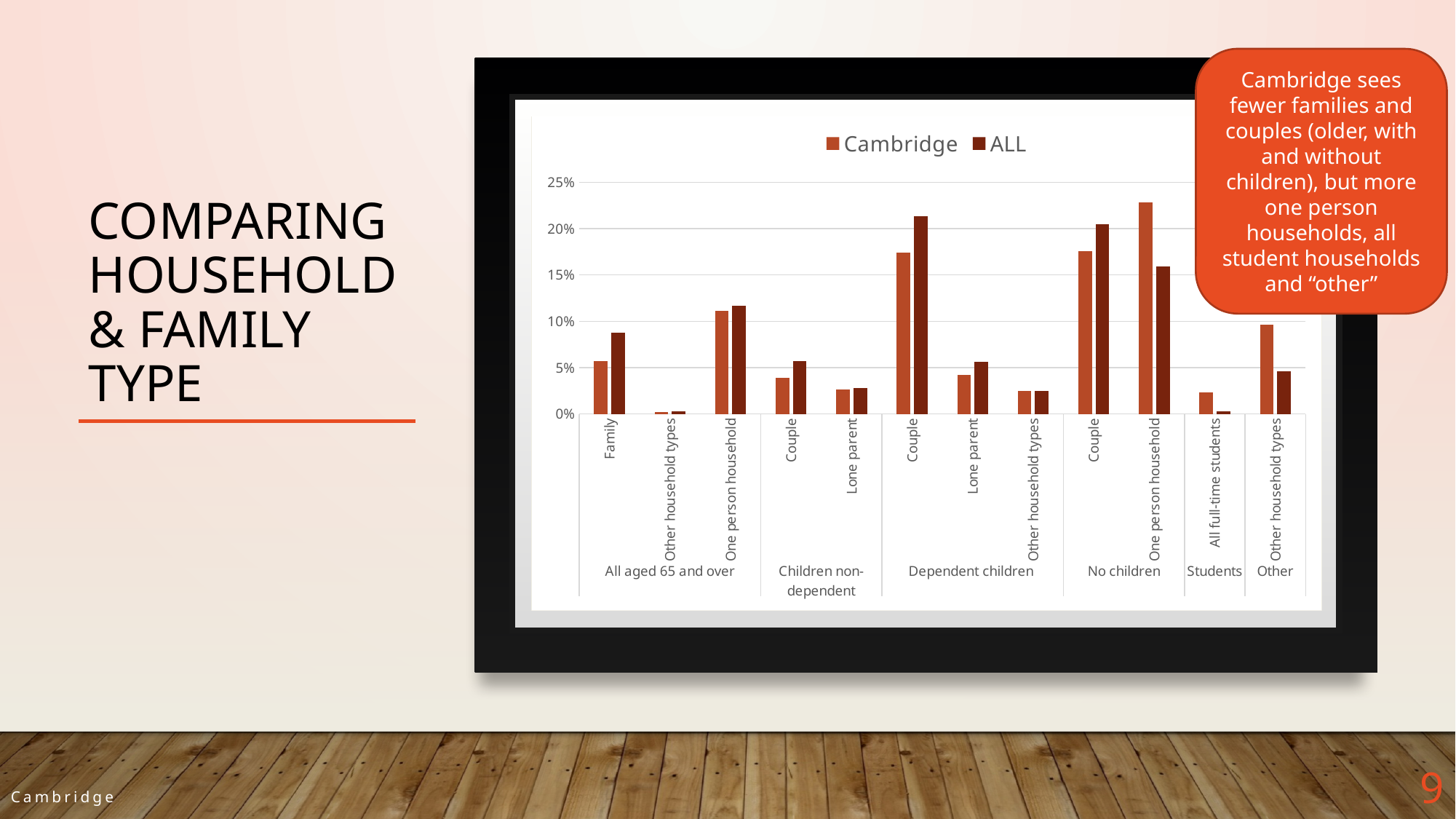
Which category has the lowest Cambridge value in the chart? Other household types (All aged 65 and over) Which category has the highest ALL value in the chart? Couple (Dependent children) Is the ALL value for Family (All aged 65 and over) greater or less than 10%? less What are the two series named in the chart legend? Cambridge and ALL How many household-type categories are plotted along the x axis of the chart? 12 Is the Cambridge value for All full-time students greater or less than 5%? less What kind of chart is shown on the slide? bar chart Is the Cambridge value for One person household (No children) greater or less than 20%? greater For Other household types (Other), which series has the larger value, Cambridge or ALL? Cambridge Which category has the highest Cambridge value in the chart? One person household (No children) For Couple (Dependent children), which series has the larger value, Cambridge or ALL? ALL How many series does the chart legend list? 2